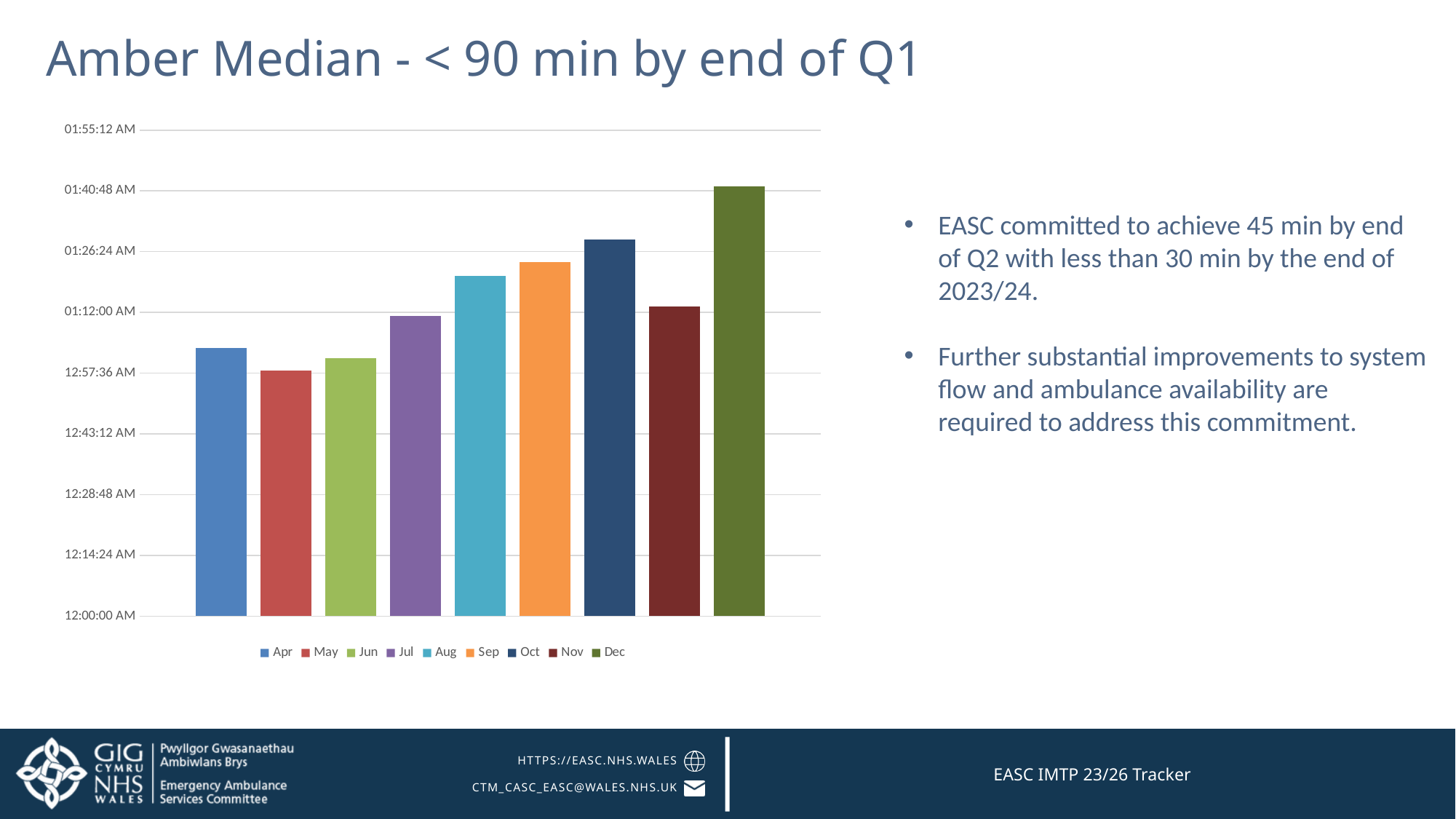
Which month has the highest bar in the chart? Dec Is the value for Apr greater or less than 12:57:36 AM? greater Which is larger, the value for Oct or the value for Nov? Oct What is the title of the slide containing the chart? Amber Median - < 90 min by end of Q1 What kind of chart is shown on the slide? Bar chart Do the values generally rise or fall from Apr to Dec? Rise Is the value for Oct greater or less than 01:26:24 AM? greater How many entries does the chart legend list? 9 How many bars are plotted in the chart? 9 Which month has the lowest bar in the chart? May Is the value for Aug greater or less than 01:26:24 AM? less Which is larger, the value for Apr or the value for May? Apr